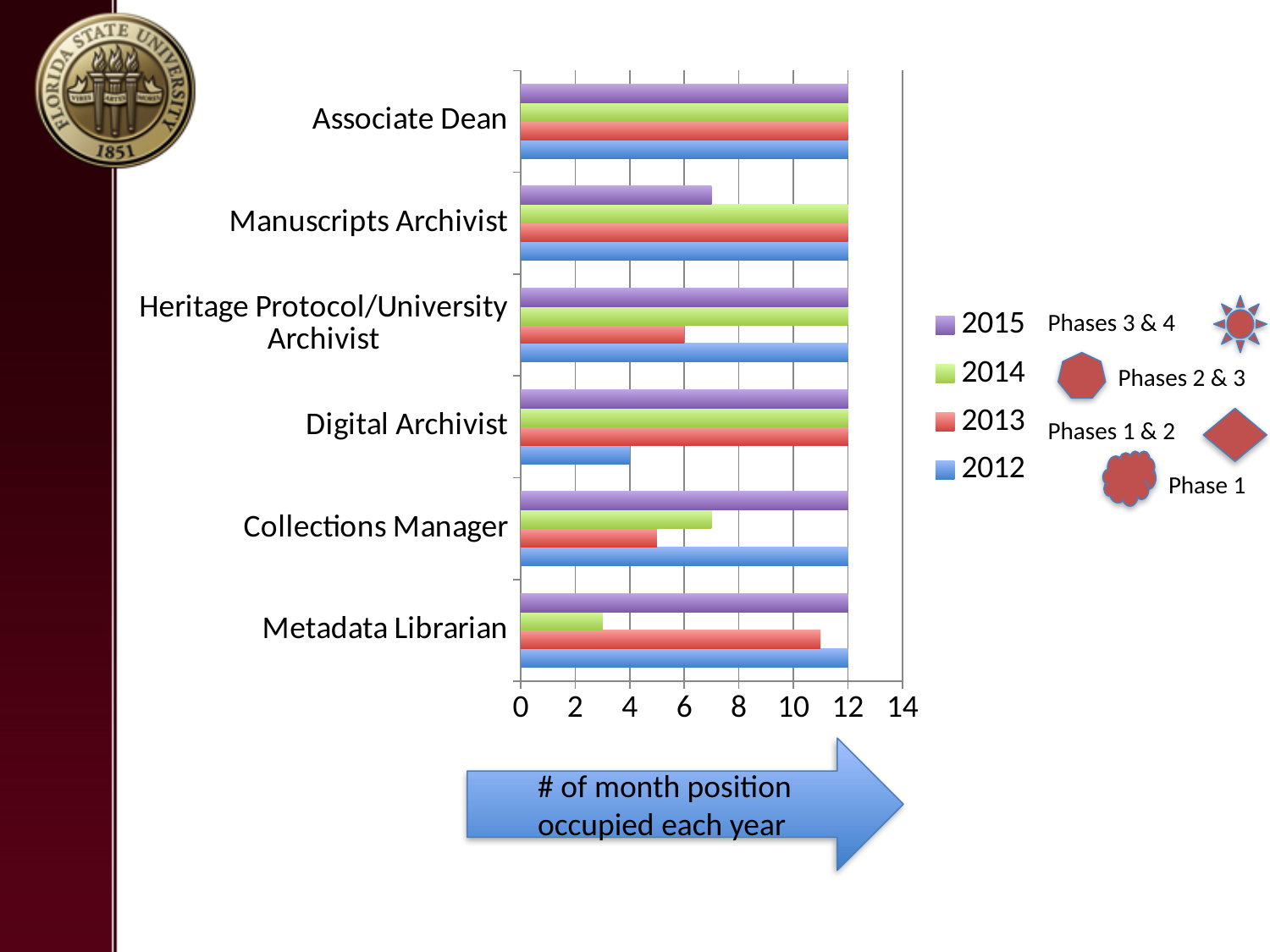
Which years are listed in the chart legend? 2015, 2014, 2013, 2012 Is the value for Manuscripts Archivist in 2015 greater or less than 8? less Which is larger for Collections Manager: the 2014 value or the 2013 value? 2014 How many positions (categories) are listed on the chart? 6 What is the value for Heritage Protocol/University Archivist in 2013? 6 Is the value for Metadata Librarian in 2013 greater or less than 10? greater Which year has the lowest value for Digital Archivist? 2012 What is the value for Digital Archivist in 2012? 4 Is the value for Metadata Librarian in 2014 greater or less than 4? less What kind of chart is shown on the slide? bar chart How many series does the chart legend list? 4 What is the value for Associate Dean in 2015? 12